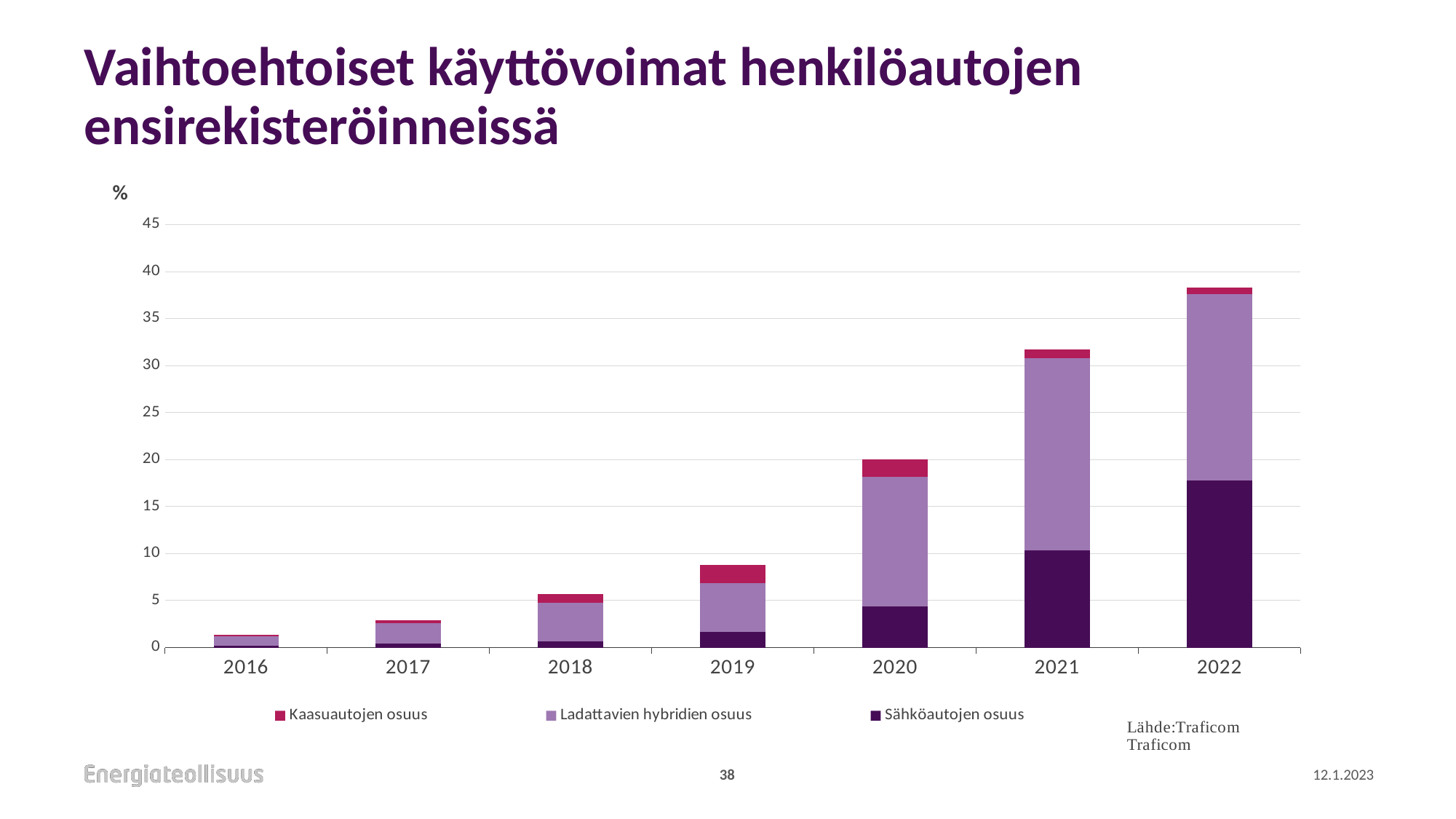
Is the total stacked bar for 2021 greater or less than 25? greater Which year has the tallest stacked bar in the chart? 2022 Is the Sähköautojen osuus segment for 2022 greater or less than 15? greater Is the total stacked bar for 2019 greater or less than 10? less Do the total bar heights rise or fall from 2016 to 2022? Rise How many series does the chart legend list? 3 What unit is shown at the top of the y axis of the chart? % What kind of chart is shown on the slide? Stacked bar chart Which series is shown in the darkest purple colour in the chart? Sähköautojen osuus How many years are shown on the x axis of the chart? 7 Which year has the shortest stacked bar in the chart? 2016